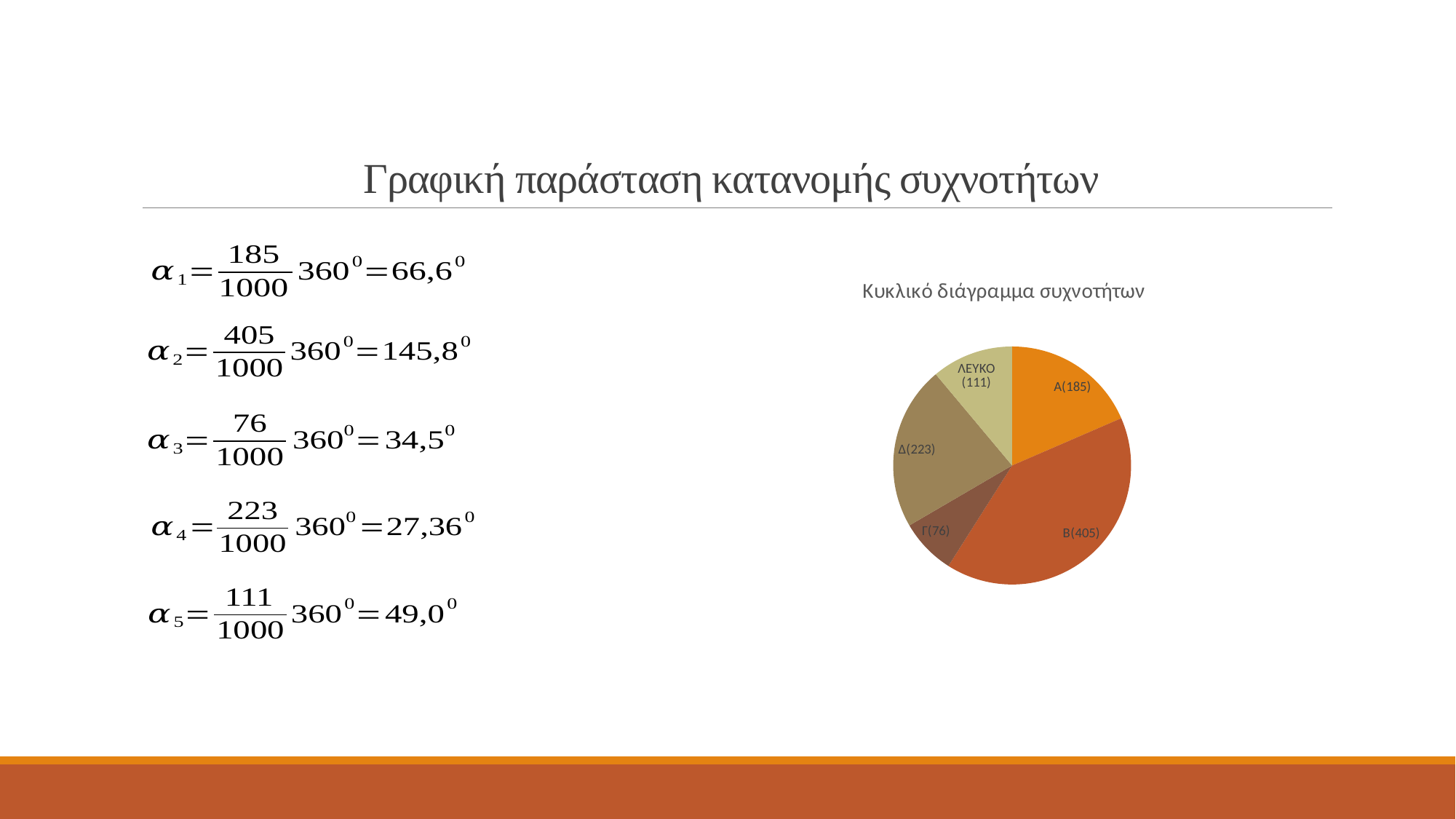
Which is larger in the pie chart, the value for Δ or the value for ΛΕΥΚΟ? Δ What is the value shown for slice Α in the pie chart? 185 What is the total of all slice values in the pie chart? 1000 What is the difference between the values of slices Β and Α in the pie chart? 220 Which slice of the pie chart has the smallest value? Γ What is the title of the pie chart? Κυκλικό διάγραμμα συχνοτήτων What share of the pie does slice Β represent? 40.5% What kind of chart is shown on the slide? pie chart What is the value shown for slice ΛΕΥΚΟ in the pie chart? 111 What is the value shown for slice Β in the pie chart? 405 Which slice of the pie chart has the largest value? Β How many slices does the pie chart have? 5